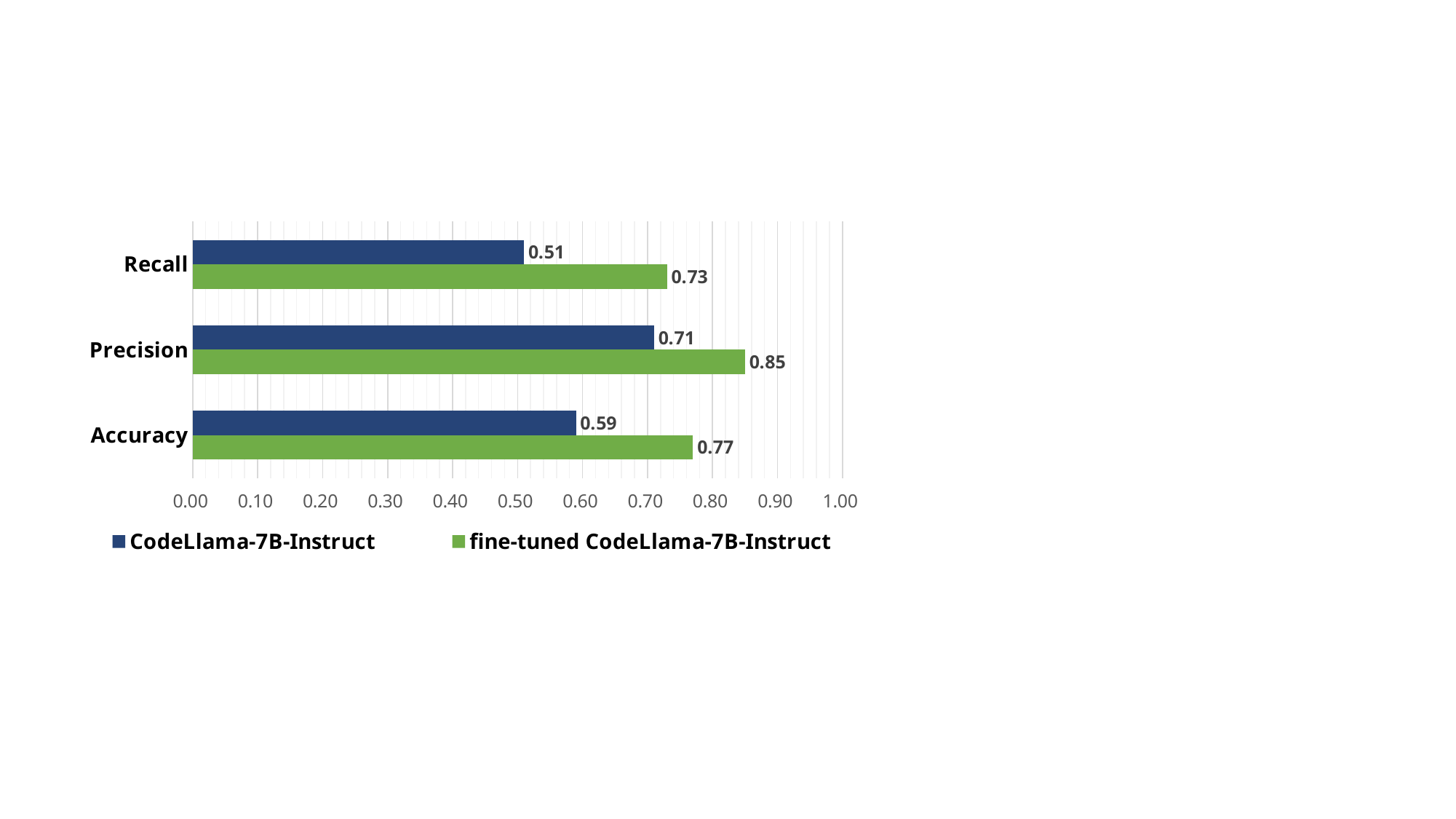
Which metric has the highest value for fine-tuned CodeLlama-7B-Instruct? Precision How many series does the legend list? 2 Which is larger: the Accuracy of CodeLlama-7B-Instruct or the Accuracy of fine-tuned CodeLlama-7B-Instruct? fine-tuned CodeLlama-7B-Instruct What is the Recall value for CodeLlama-7B-Instruct? 0.51 What is the Precision value for fine-tuned CodeLlama-7B-Instruct? 0.85 What is the Accuracy value for CodeLlama-7B-Instruct? 0.59 What kind of chart is shown on the slide? Bar chart How many metrics (categories) are shown on the chart? 3 Which metric has the lowest value for CodeLlama-7B-Instruct? Recall What is the difference between the Precision values of fine-tuned CodeLlama-7B-Instruct and CodeLlama-7B-Instruct? 0.14 Is the Recall value for CodeLlama-7B-Instruct greater or less than 0.60? less What is the Recall value for fine-tuned CodeLlama-7B-Instruct? 0.73